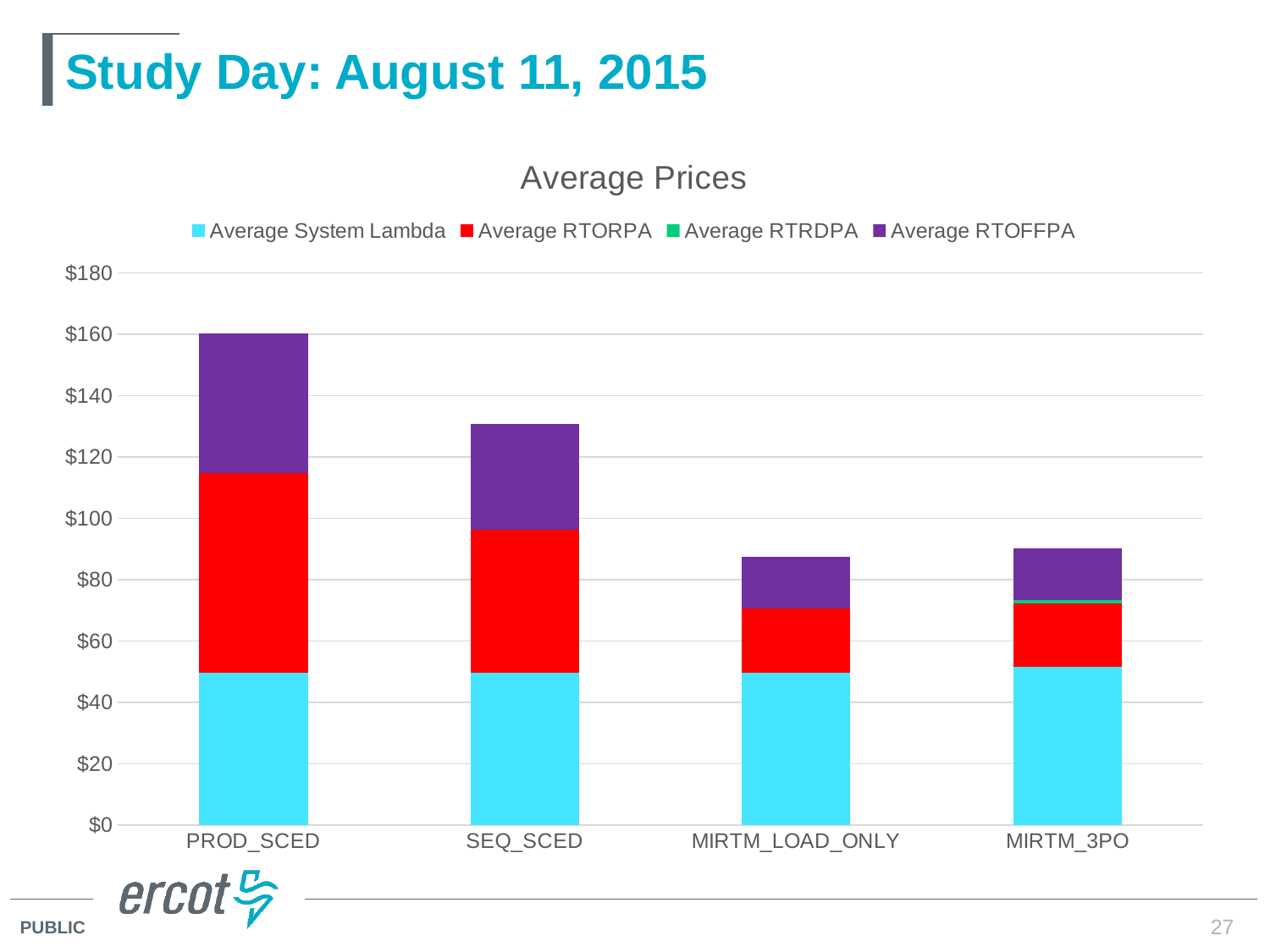
How many categories are shown on the x axis? 4 Is the total bar for MIRTM_LOAD_ONLY greater or less than $100? less Which has the taller total bar, PROD_SCED or SEQ_SCED? PROD_SCED Is the total bar for PROD_SCED greater or less than $140? greater What type of chart is shown on the slide? stacked bar chart How many series does the legend list? 4 Which series is shown in red in the legend? Average RTORPA Is the total bar for MIRTM_3PO greater or less than $80? greater What is the title of the chart? Average Prices Which category has the larger Average RTORPA segment, PROD_SCED or MIRTM_LOAD_ONLY? PROD_SCED Which category has the highest total stacked bar? PROD_SCED